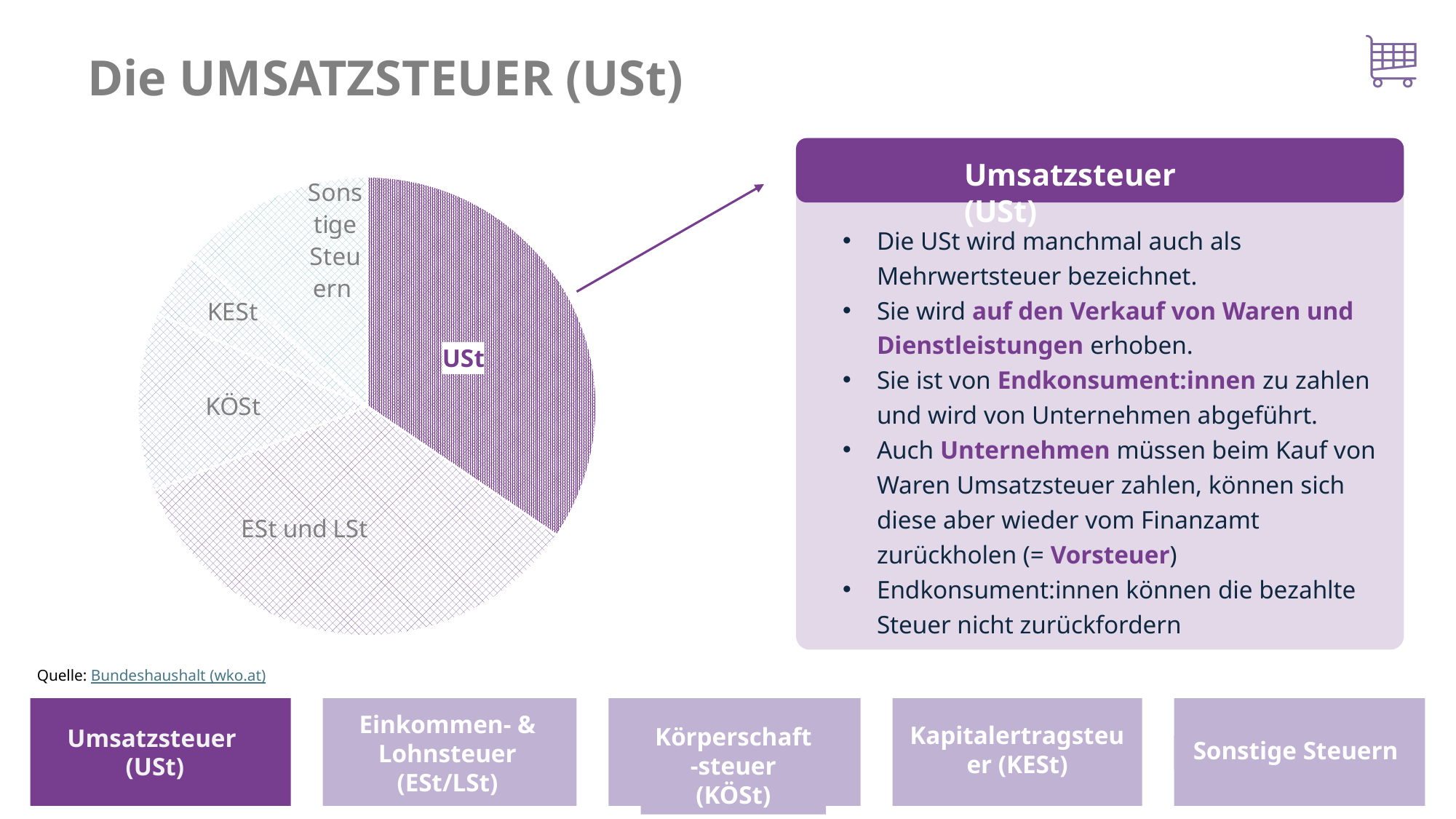
Which is larger in the pie chart, USt or KÖSt? USt Which is larger in the pie chart, ESt und LSt or KESt? ESt und LSt What kind of chart is shown on the slide? pie chart Which slice of the pie chart is the smallest? KESt What is the title of the slide containing the pie chart? Die UMSATZSTEUER (USt) How many slices does the pie chart have? 5 Which is larger in the pie chart, ESt und LSt or Sonstige Steuern? ESt und LSt Which slice of the pie chart is highlighted in solid purple? USt